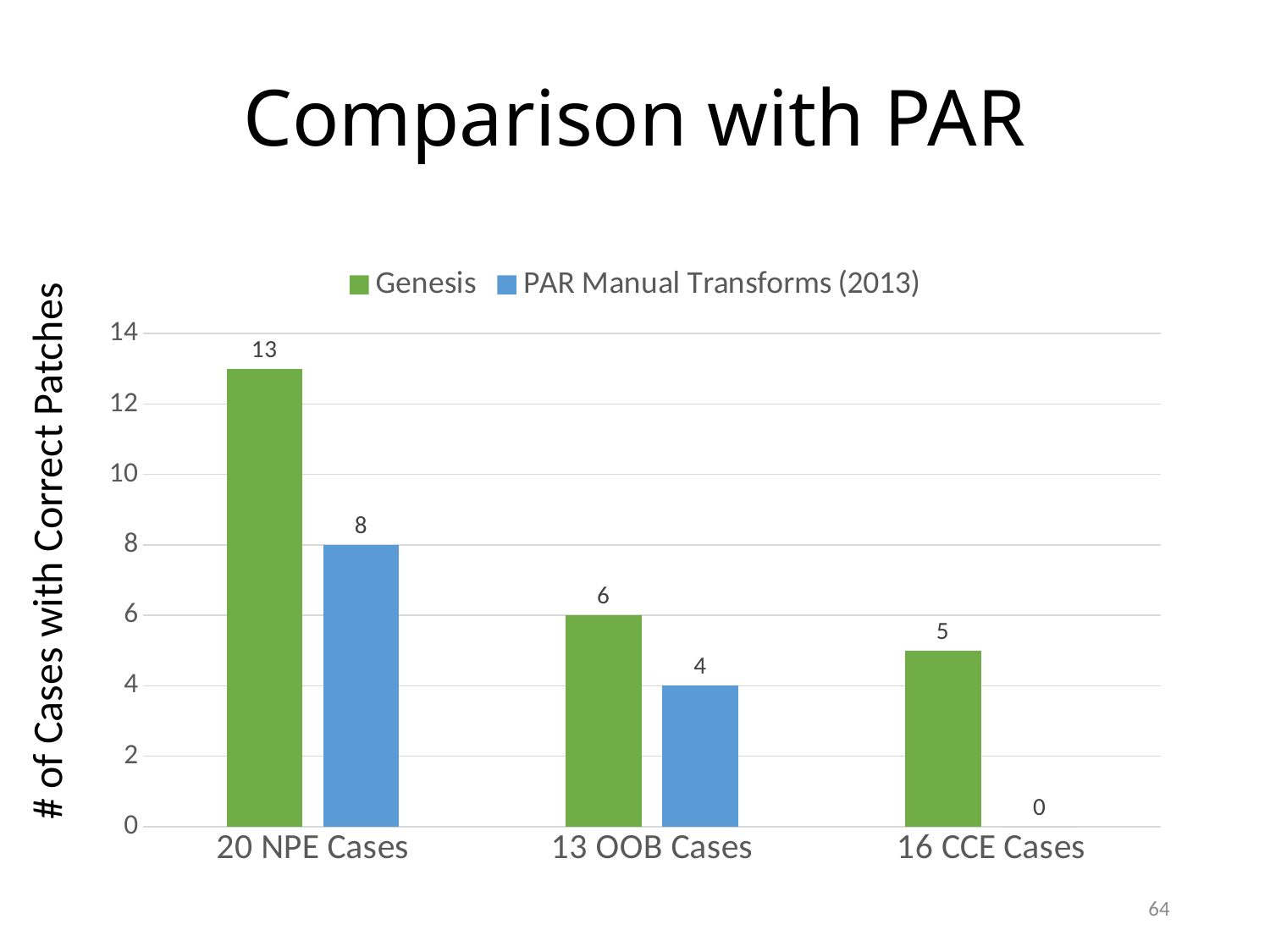
What is the value for Genesis in the 20 NPE Cases category? 13 How many categories are shown on the x axis? 3 What is the value for PAR Manual Transforms (2013) in the 16 CCE Cases category? 0 How many series does the legend list? 2 What is the label of the y axis? # of Cases with Correct Patches Which category has the highest value for Genesis? 20 NPE Cases What kind of chart is shown on the slide? Bar chart What is the difference between Genesis and PAR Manual Transforms (2013) in the 20 NPE Cases category? 5 What is the value for PAR Manual Transforms (2013) in the 13 OOB Cases category? 4 Which is larger in the 13 OOB Cases category: Genesis or PAR Manual Transforms (2013)? Genesis Which category has the lowest value for PAR Manual Transforms (2013)? 16 CCE Cases Do the Genesis values rise or fall from left to right across the categories? Fall